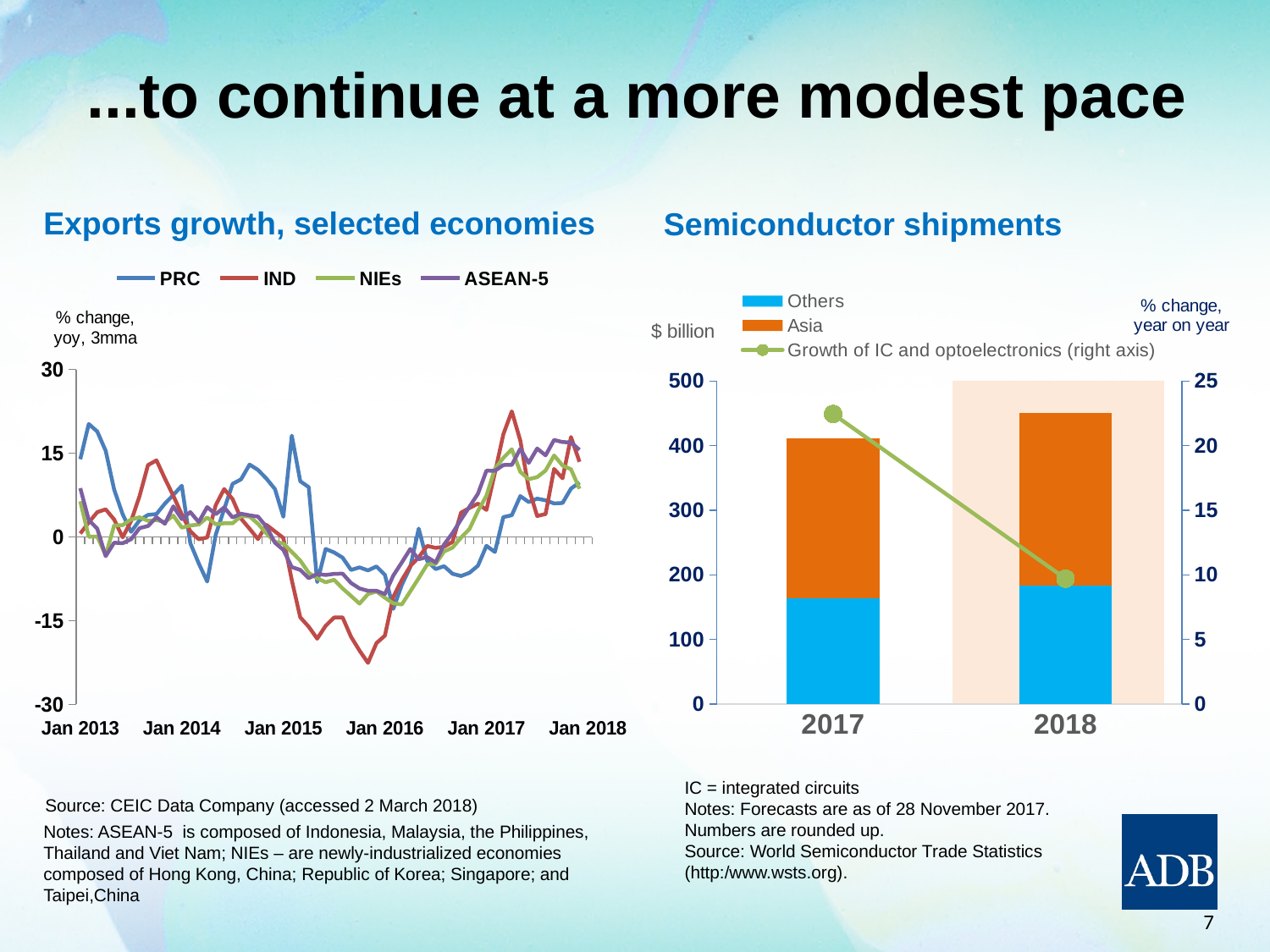
What type of chart is the 'Exports growth, selected economies' chart? line chart How many series does the legend of the 'Exports growth, selected economies' chart list? 4 In the 'Semiconductor shipments' chart, which year has the larger total stacked bar, 2017 or 2018? 2018 In the 'Exports growth, selected economies' chart, which series is shown in red? IND In the 'Exports growth, selected economies' chart, is the lowest value of the IND series greater or less than -15? less How many entries does the legend of the 'Semiconductor shipments' chart list? 3 In the 'Semiconductor shipments' chart, is the total stacked bar for 2018 greater or less than 400? greater In the 'Semiconductor shipments' chart, does the 'Growth of IC and optoelectronics' line rise or fall from 2017 to 2018? fall In the 'Semiconductor shipments' chart, is the 'Growth of IC and optoelectronics' value for 2017 greater or less than 20? greater How many years are shown on the x axis of the 'Semiconductor shipments' chart? 2 What type of chart is the 'Semiconductor shipments' chart? combination bar and line chart